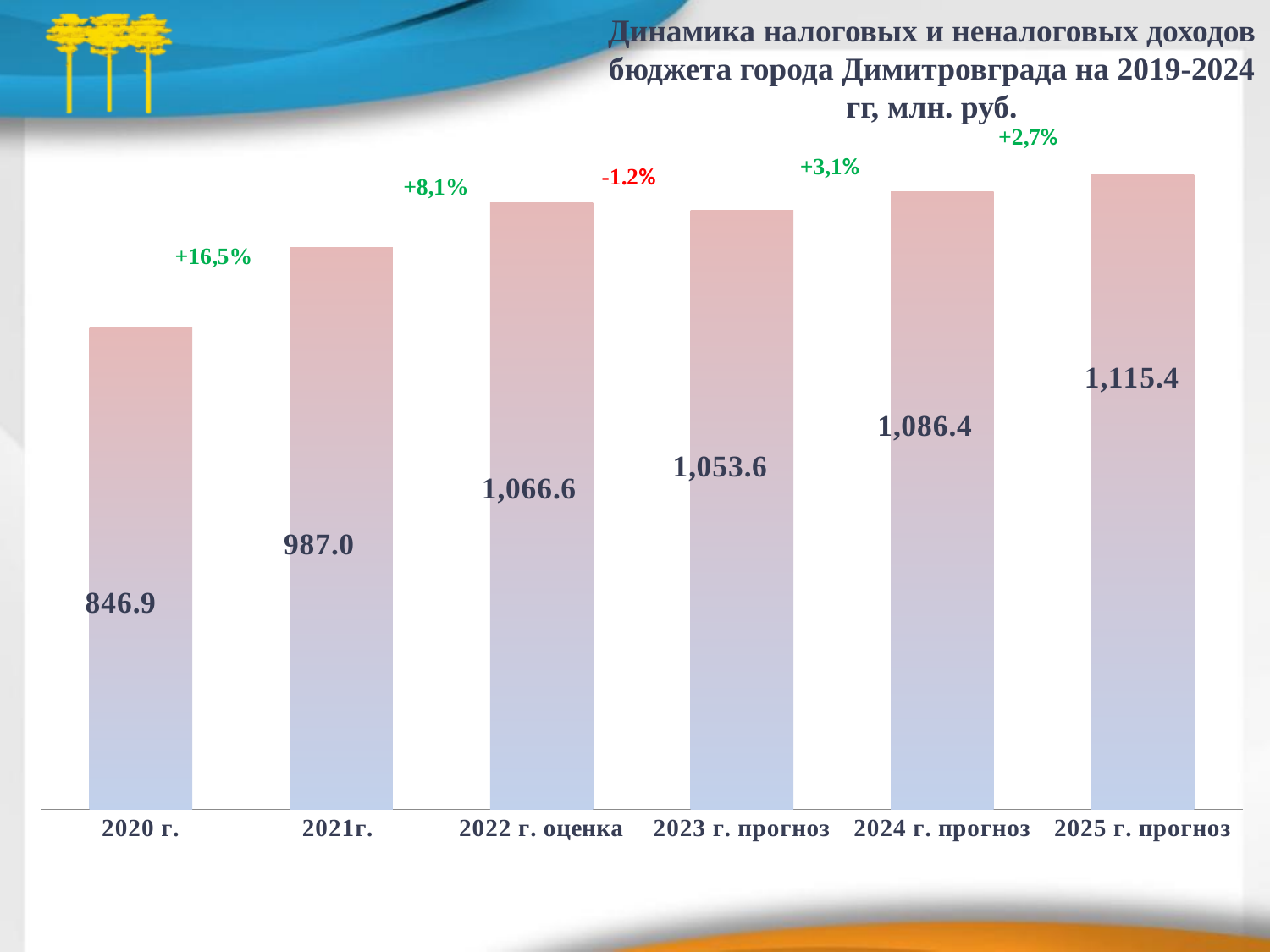
What is the value for 2024 г. прогноз? 1,086.4 What is the value for 2020 г.? 846.9 What is the difference between the values for 2021г. and 2020 г.? 140.1 How many bars are shown in the chart? 6 What percentage change is shown between 2022 г. оценка and 2023 г. прогноз? -1.2% What is the value for 2022 г. оценка? 1,066.6 Which year has the highest value? 2025 г. прогноз What kind of chart is shown on the slide? Bar chart Which year has the lowest value? 2020 г. Which is larger, the value for 2022 г. оценка or 2023 г. прогноз? 2022 г. оценка Do the values rise or fall from 2020 г. to 2022 г. оценка? Rise What is the difference between the values for 2025 г. прогноз and 2024 г. прогноз? 29.0